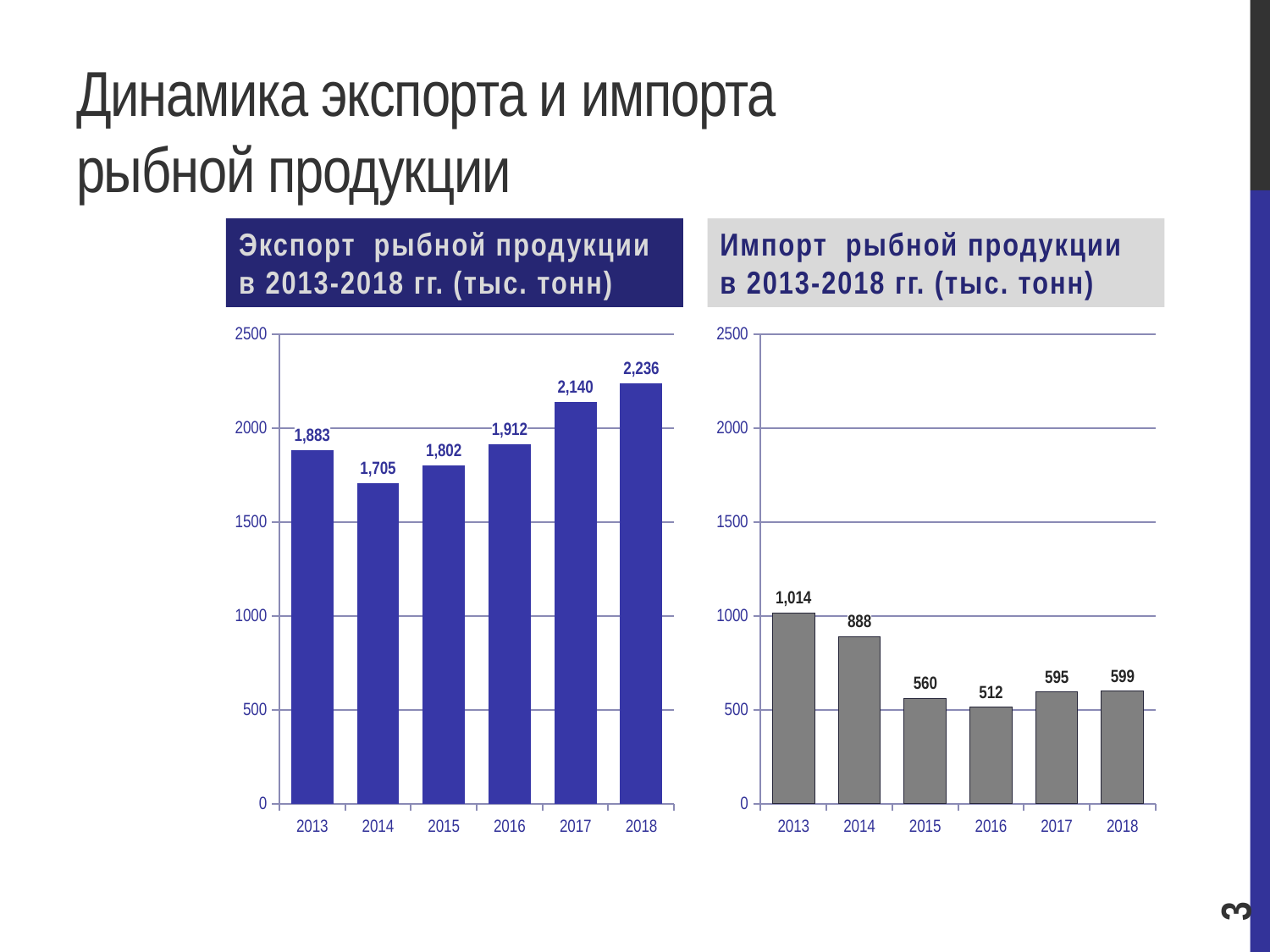
In the import chart (right), do the values generally rise or fall from 2013 to 2016? fall In the import chart (right), what is the value for 2014? 888 In the import chart (right), what is the difference between the 2013 value and the 2014 value? 126 In the export chart (left), what is the difference between the 2018 value and the 2013 value? 353 In the import chart (right), which year has the lowest value? 2016 In the import chart (right), is the value for 2013 greater or less than 1000? greater In the export chart (left), which is larger: the value for 2015 or the value for 2016? 2016 What type of chart is the export chart (left)? bar chart How many years are shown on the x axis of the import chart (right)? 6 In the export chart (left), which year has the lowest value? 2014 In the export chart (left), what is the value for 2017? 2,140 In the export chart (left), which year has the highest value? 2018